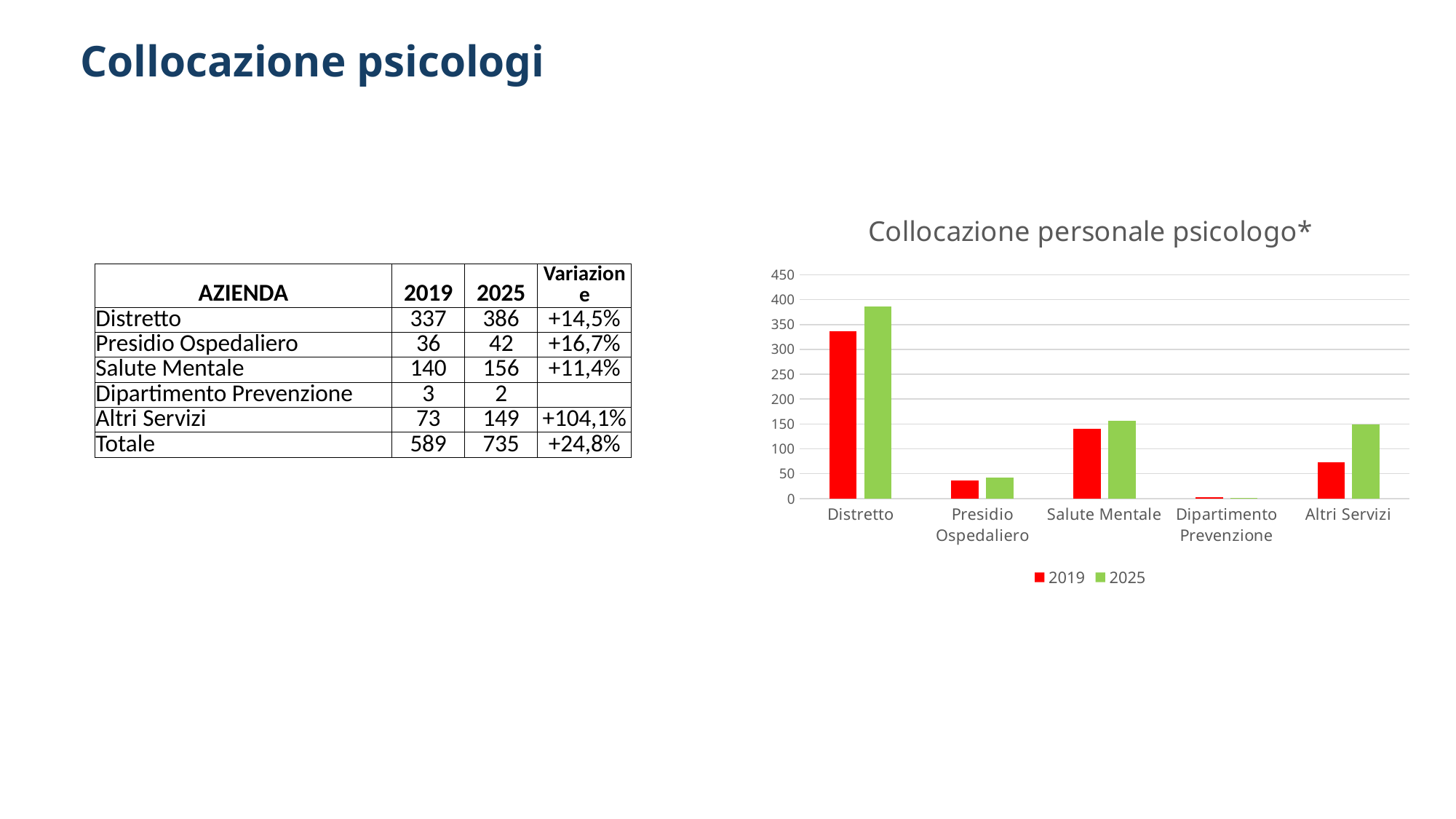
How many series does the chart legend list? 2 Which category has the highest value for the 2025 series? Distretto Is the 2019 value for Altri Servizi greater or less than 100? less Is the 2025 value for Distretto greater or less than 350? greater What is the value for Distretto in 2019, as printed in the table on the slide? 337 What kind of chart is shown on the slide? bar chart How many categories are shown on the x axis of the chart? 5 What is the title of the chart? Collocazione personale psicologo* Which category has the lowest value for the 2019 series? Dipartimento Prevenzione Which is larger for Altri Servizi, the 2019 value or the 2025 value? 2025 What is the difference between the 2025 and 2019 values for Altri Servizi, using the values printed in the table? 76 Is the 2025 value for Salute Mentale greater or less than 150? greater